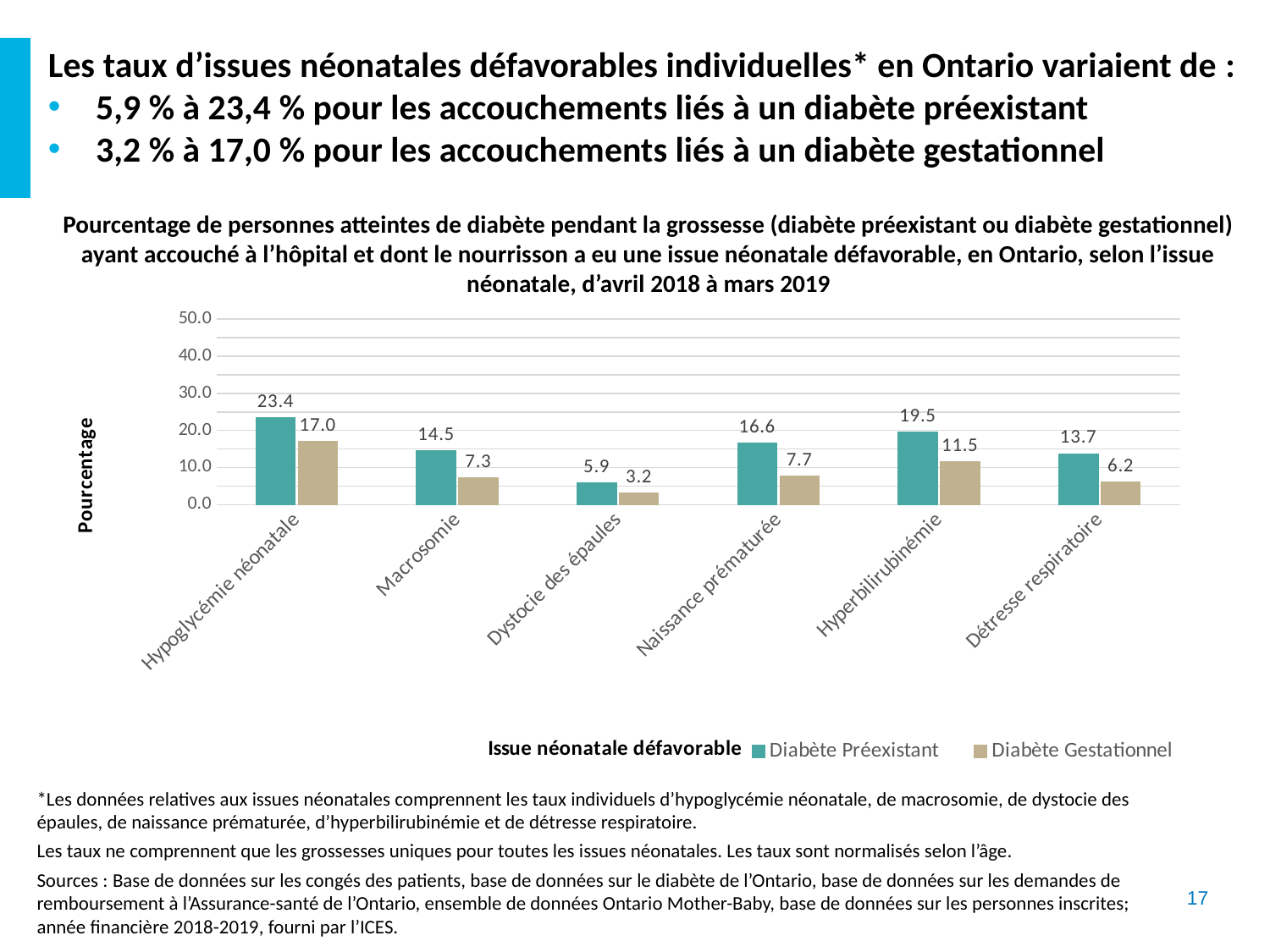
What is the difference between the Diabète Préexistant and Diabète Gestationnel values for Macrosomie? 7.2 What type of chart is shown on the slide? Bar chart Is the value for Diabète Préexistant for Détresse respiratoire greater or less than 10.0? greater How many neonatal outcome categories are shown on the x axis? 6 What is the value for Diabète Gestationnel for Hyperbilirubinémie? 11.5 Which category has the lowest value for Diabète Gestationnel? Dystocie des épaules Which category has the highest value for Diabète Préexistant? Hypoglycémie néonatale What is the value for Diabète Gestationnel for Dystocie des épaules? 3.2 What is the label of the y axis? Pourcentage How many series does the legend list? 2 Which is larger for Naissance prématurée: the Diabète Préexistant value or the Diabète Gestationnel value? Diabète Préexistant What is the value for Diabète Préexistant for Hypoglycémie néonatale? 23.4